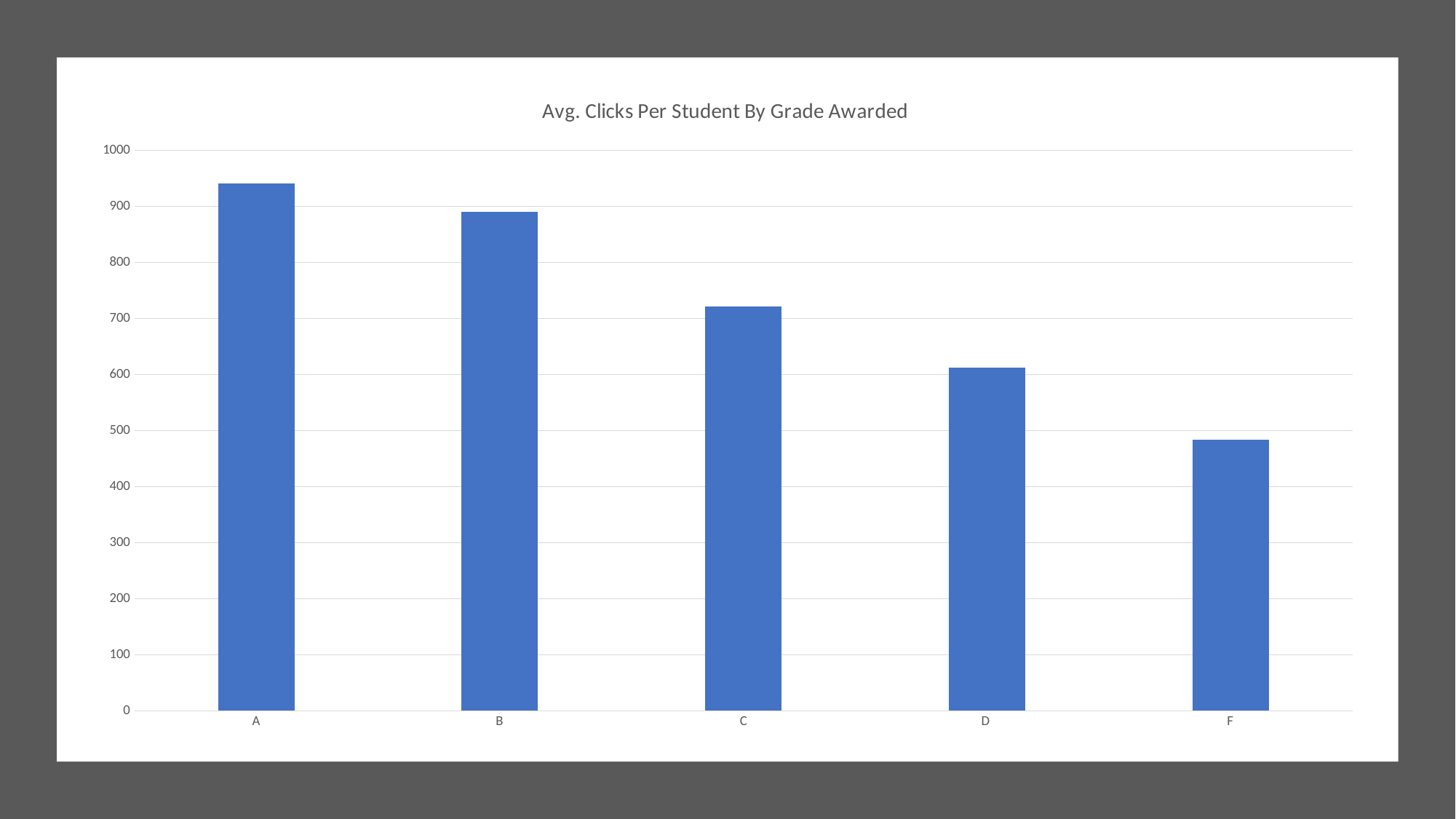
Is the value for grade F greater or less than 500? less What type of chart is shown on the slide? bar chart How many grade categories are shown on the x axis? 5 Which grade has the highest average clicks per student? A Is the value for grade D greater or less than 700? less What is the title of the chart? Avg. Clicks Per Student By Grade Awarded Is the value for grade B greater or less than 900? less Which has a larger value, grade C or grade D? C Which grade has the lowest average clicks per student? F Do the values rise or fall moving from grade A to grade F along the x axis? fall